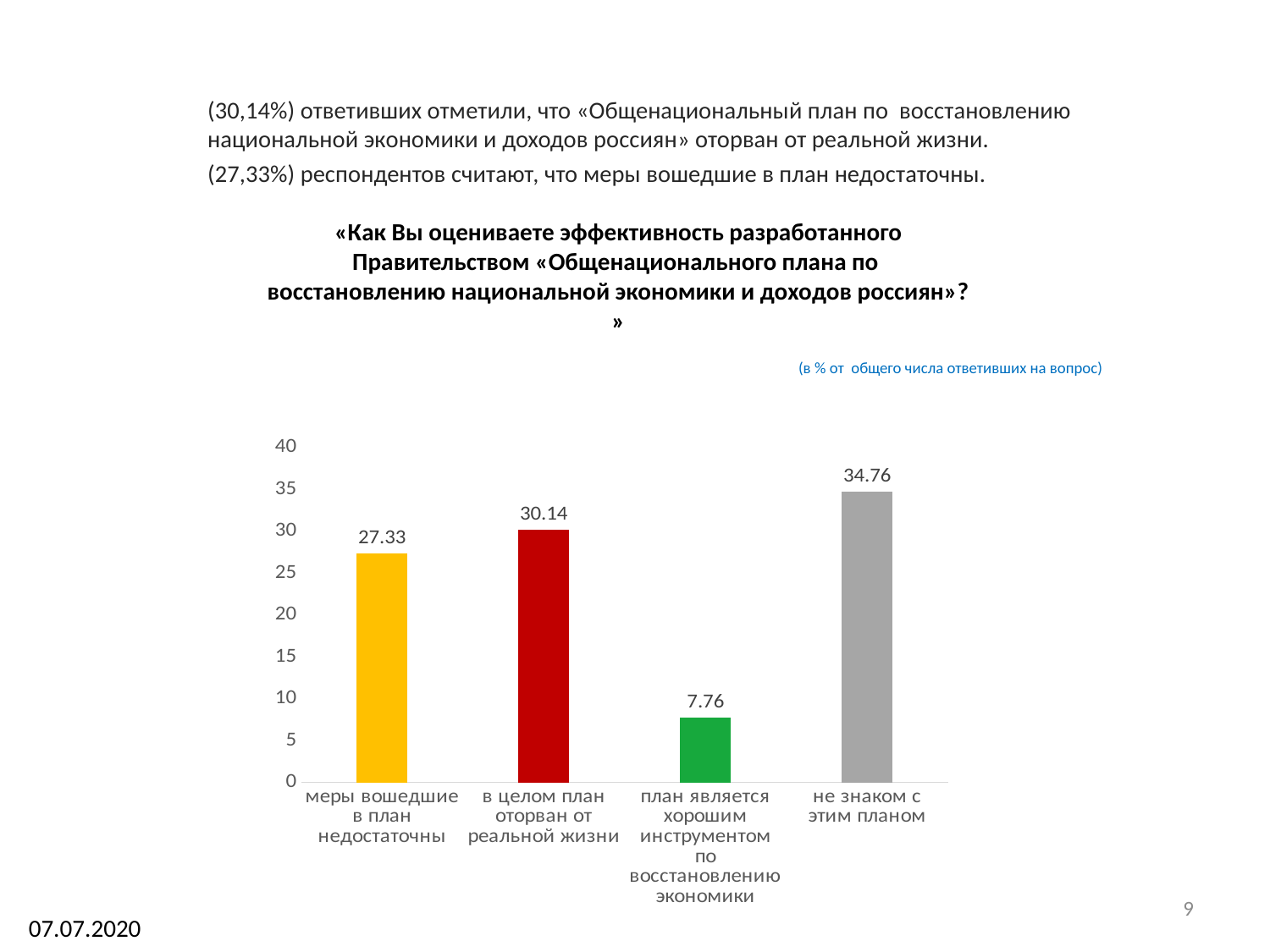
What is the value for «не знаком с этим планом»? 34.76 Which category has the highest value? не знаком с этим планом Which category has the lowest value? план является хорошим инструментом по восстановлению экономики What is the value for «меры вошедшие в план недостаточны»? 27.33 What is the value for «план является хорошим инструментом по восстановлению экономики»? 7.76 What colour is the bar for «в целом план оторван от реальной жизни»? red What is the difference between the values for «меры вошедшие в план недостаточны» and «план является хорошим инструментом по восстановлению экономики»? 19.57 Is the value for «план является хорошим инструментом по восстановлению экономики» greater or less than 10? less What kind of chart is shown on the slide? bar chart Which is larger: the value for «в целом план оторван от реальной жизни» or for «меры вошедшие в план недостаточны»? в целом план оторван от реальной жизни What is the difference between the values for «не знаком с этим планом» and «в целом план оторван от реальной жизни»? 4.62 How many categories are shown in the chart? 4